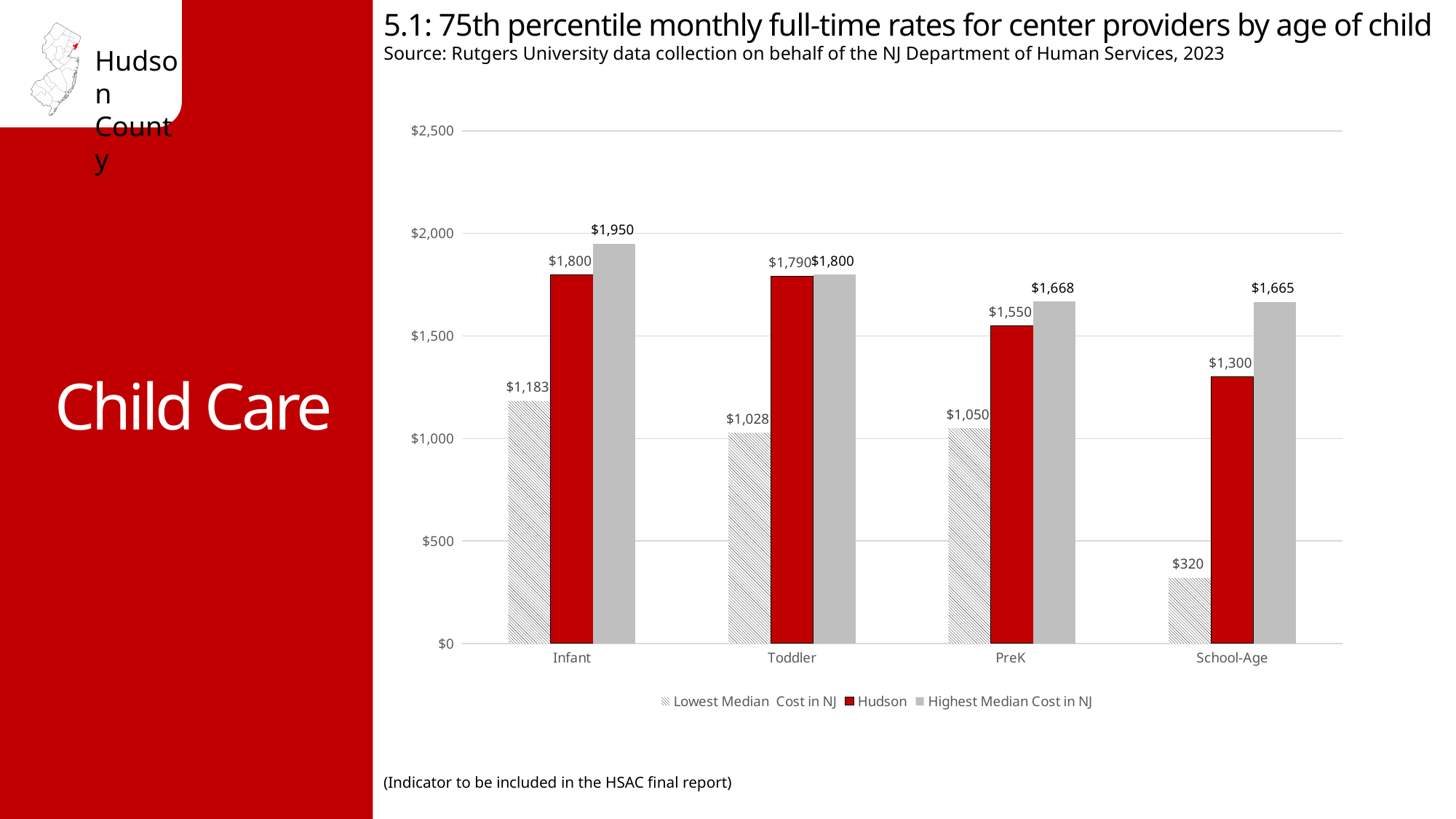
How many series does the legend list? 3 Which is larger for Toddler: the Hudson value or the Lowest Median Cost in NJ? Hudson Is the Hudson value for PreK greater or less than $1,500? greater What is the difference between the Hudson value and the Lowest Median Cost in NJ for School-Age? $980 Which age group has the lowest Lowest Median Cost in NJ value? School-Age What is the difference between the Highest Median Cost in NJ and the Hudson value for Infant? $150 How many age groups are shown on the x axis? 4 What kind of chart is shown on the slide? Bar chart What is the Lowest Median Cost in NJ for School-Age? $320 Which age group has the highest Hudson value? Infant What is the Hudson value for Infant? $1,800 What is the Highest Median Cost in NJ for PreK? $1,668